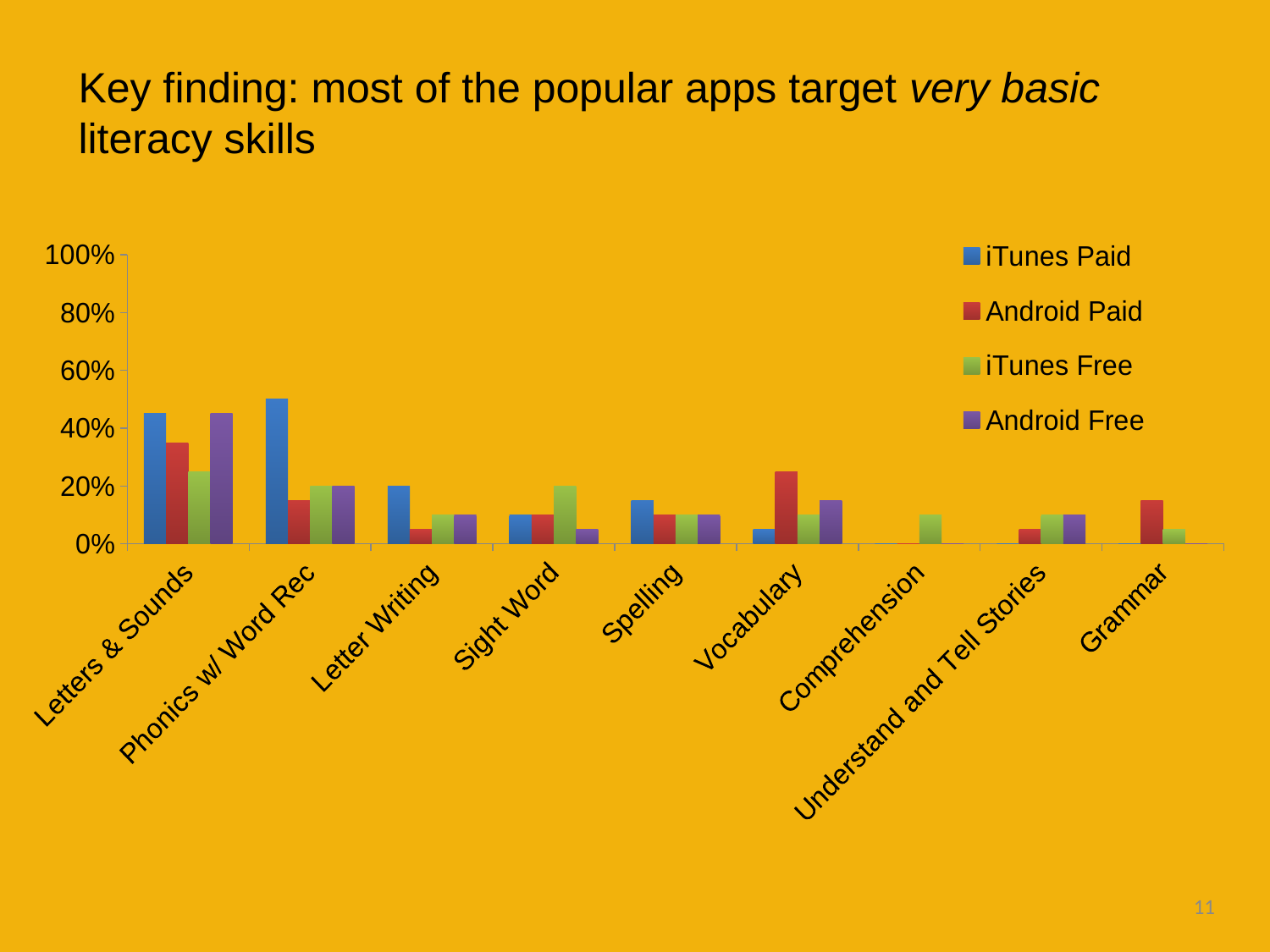
How many series does the legend list? 4 For Vocabulary, which is larger: the iTunes Paid value or the Android Paid value? Android Paid How many literacy skill categories are shown on the x axis? 9 Is the Android Paid value for Letters & Sounds greater or less than 40%? less Is the iTunes Paid value for Letters & Sounds greater or less than 40%? greater For Letters & Sounds, which is larger: the Android Paid value or the iTunes Free value? Android Paid Is the iTunes Paid value for Phonics w/ Word Rec greater or less than 40%? greater Which category has the highest Android Free value? Letters & Sounds What colour represents the Android Free series in the legend? purple What kind of chart is shown on the slide? bar chart Which category has the highest iTunes Paid value? Phonics w/ Word Rec